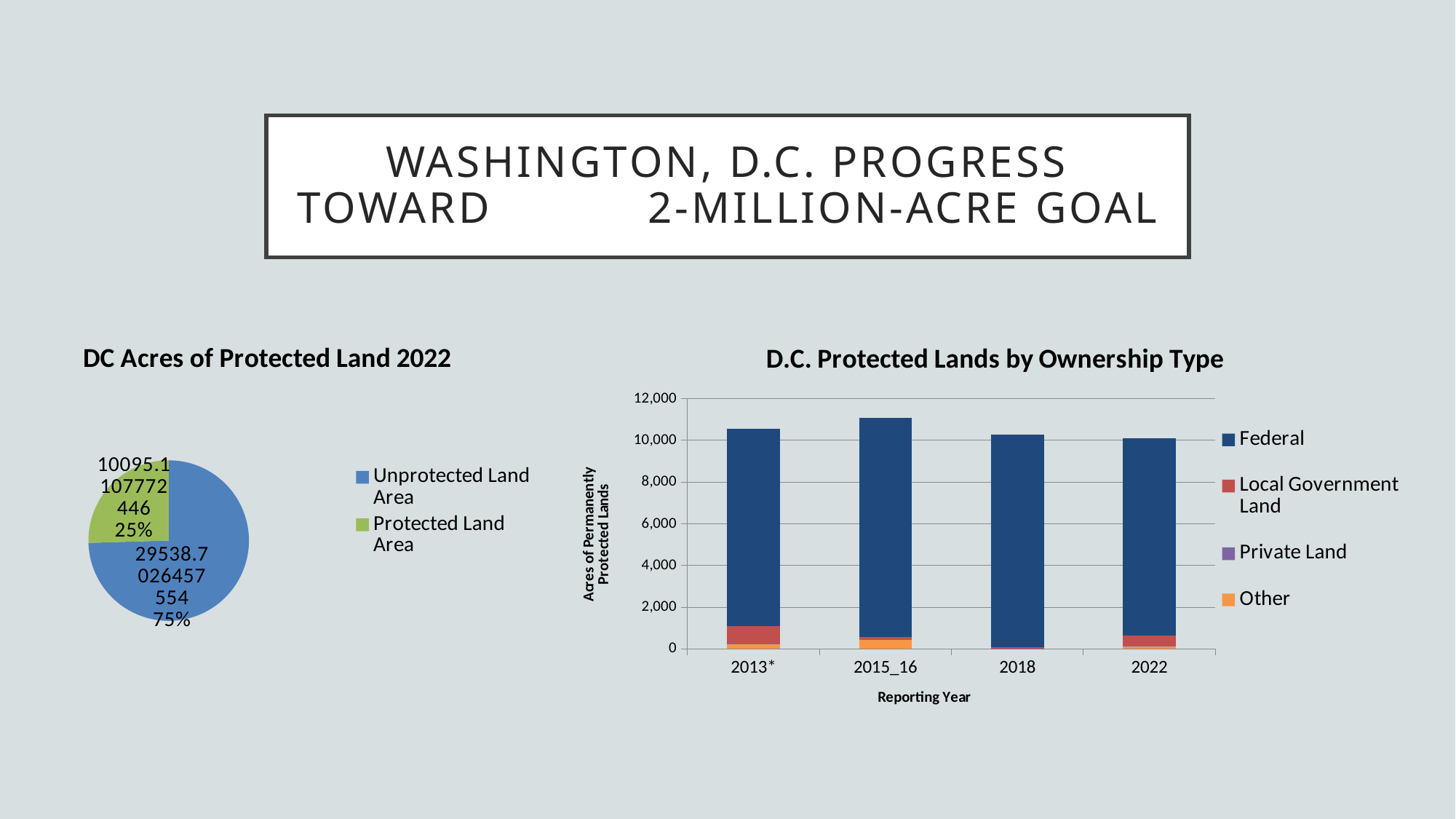
In the pie chart 'DC Acres of Protected Land 2022', which slice is larger, Unprotected Land Area or Protected Land Area? Unprotected Land Area In 'D.C. Protected Lands by Ownership Type', is the total stacked bar for 2018 greater or less than 12,000? less What kind of chart is 'DC Acres of Protected Land 2022'? Pie chart In the pie chart 'DC Acres of Protected Land 2022', what share of the pie is Unprotected Land Area? 75% What kind of chart is 'D.C. Protected Lands by Ownership Type'? Stacked bar chart In the pie chart 'DC Acres of Protected Land 2022', what share of the pie is Protected Land Area? 25% How many reporting years are shown on the x axis of 'D.C. Protected Lands by Ownership Type'? 4 How many slices does the pie chart 'DC Acres of Protected Land 2022' have? 2 What is the x-axis title of the chart 'D.C. Protected Lands by Ownership Type'? Reporting Year How many series does the legend of 'D.C. Protected Lands by Ownership Type' list? 4 In 'D.C. Protected Lands by Ownership Type', which reporting year has the tallest stacked bar? 2015_16 In 'D.C. Protected Lands by Ownership Type', is the total stacked bar for 2015_16 greater or less than 10,000? greater